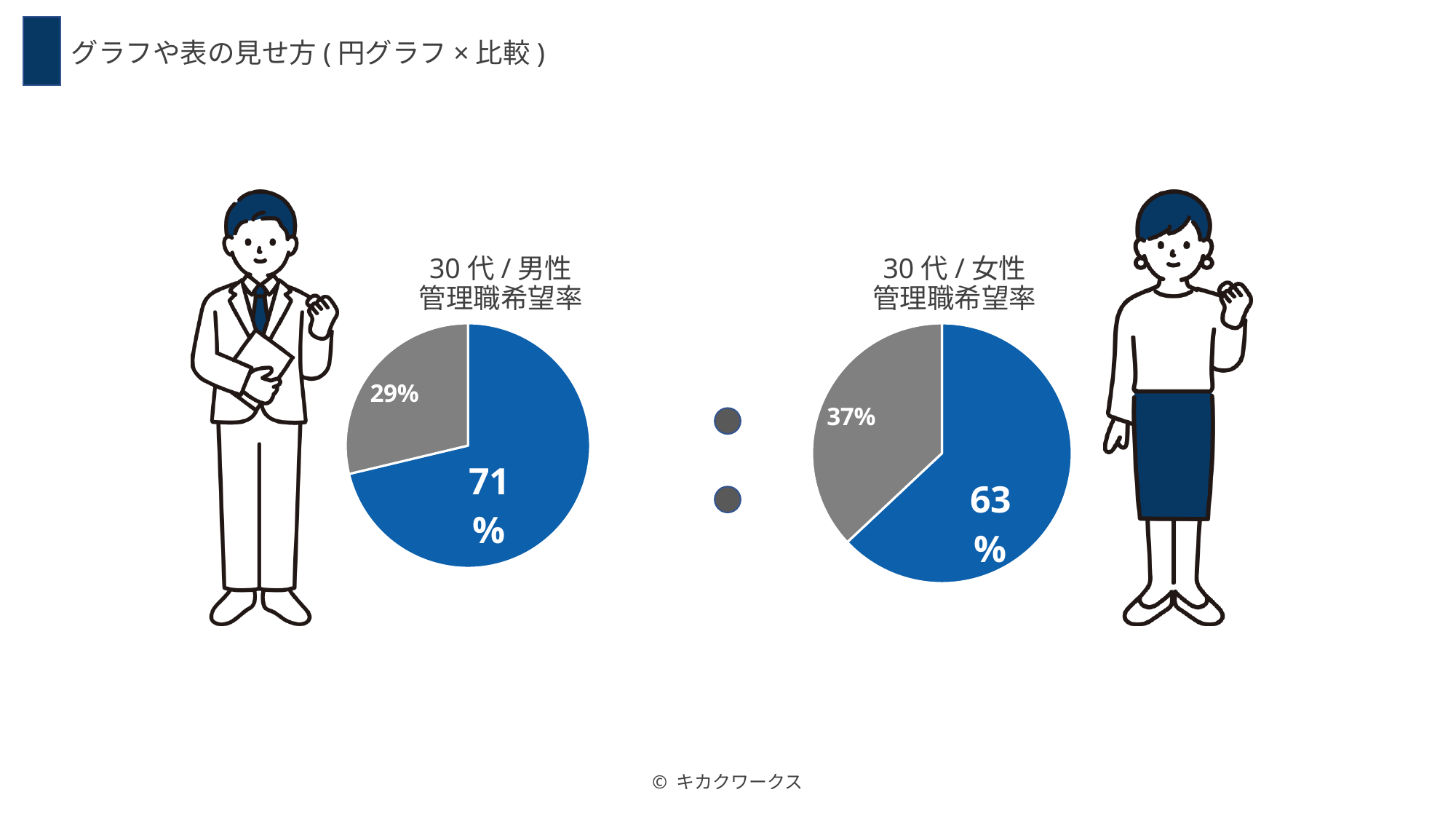
What type of chart is used on this slide? pie chart In the right pie chart (30代/女性 管理職希望率), what value is shown on the grey slice? 37% In the left pie chart (30代/男性 管理職希望率), what value is shown on the grey slice? 29% What is the title of the pie chart on the right side of the slide? 30代/女性 管理職希望率 In the right pie chart (30代/女性 管理職希望率), which slice is the smallest? the grey slice (37%) How many slices does the right pie chart (30代/女性 管理職希望率) have? 2 What is the difference between the blue slice of the left pie chart (71%) and the blue slice of the right pie chart (63%)? 8% In the left pie chart (30代/男性 管理職希望率), what is the difference between the blue slice and the grey slice? 42% Which is larger: the blue slice in the left pie chart (30代/男性) or the blue slice in the right pie chart (30代/女性)? the left pie chart (30代/男性), 71% In the left pie chart (30代/男性 管理職希望率), which slice is the largest? the blue slice (71%) In the left pie chart (30代/男性 管理職希望率), what value is shown on the blue slice? 71% In the right pie chart (30代/女性 管理職希望率), what value is shown on the blue slice? 63%